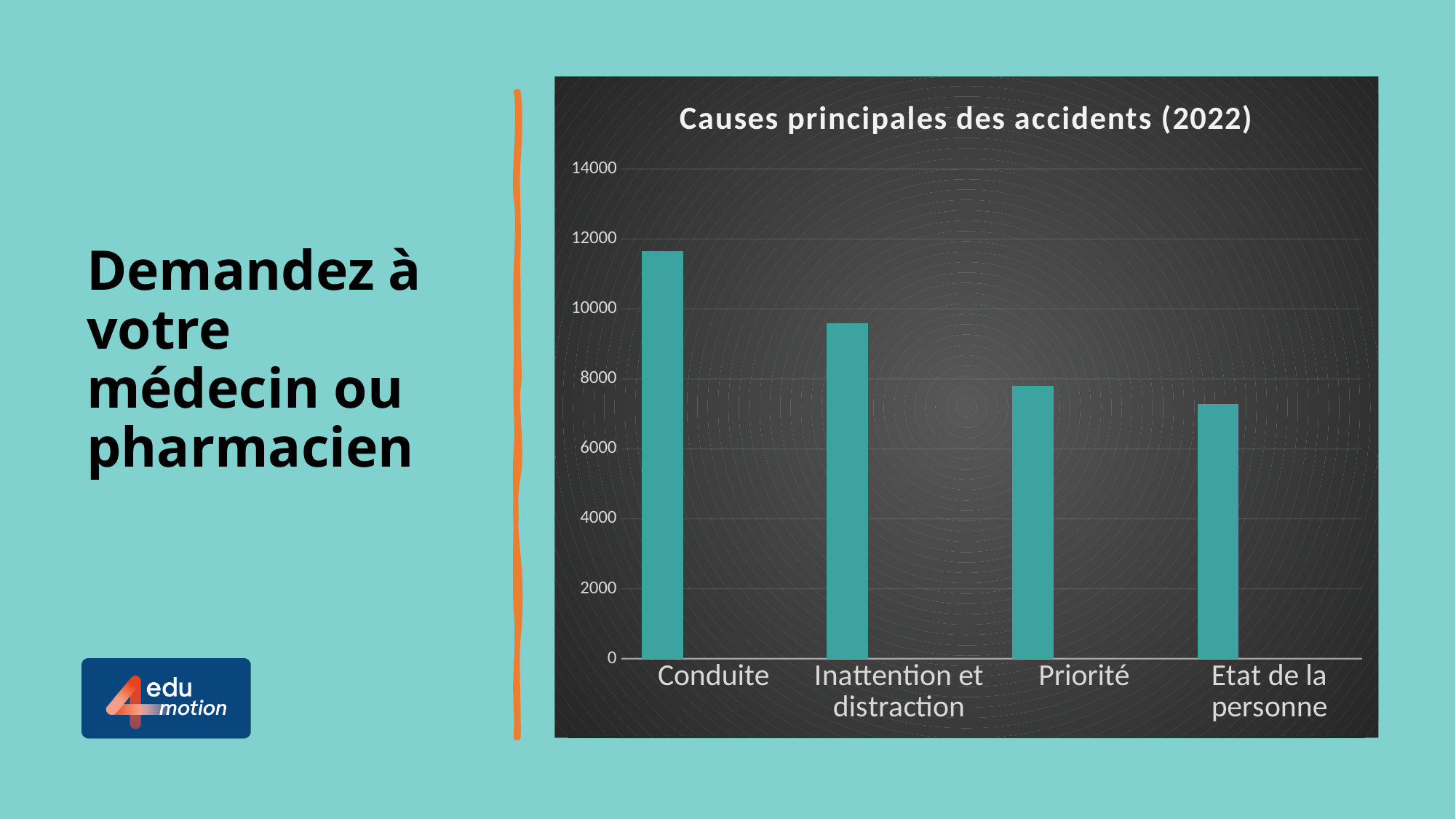
Which category has the highest value in the chart? Conduite What is the title of the chart? Causes principales des accidents (2022) Is the value for Conduite greater or less than 12000? less Is the value for Conduite greater or less than 10000? greater Do the values rise or fall from left to right along the x axis? fall Which is larger, the value for Conduite or the value for Inattention et distraction? Conduite What kind of chart is shown on the slide? bar chart Is the value for Etat de la personne greater or less than 6000? greater Which is larger, the value for Inattention et distraction or the value for Priorité? Inattention et distraction How many categories are shown on the x axis of the chart? 4 Which category has the lowest value in the chart? Etat de la personne